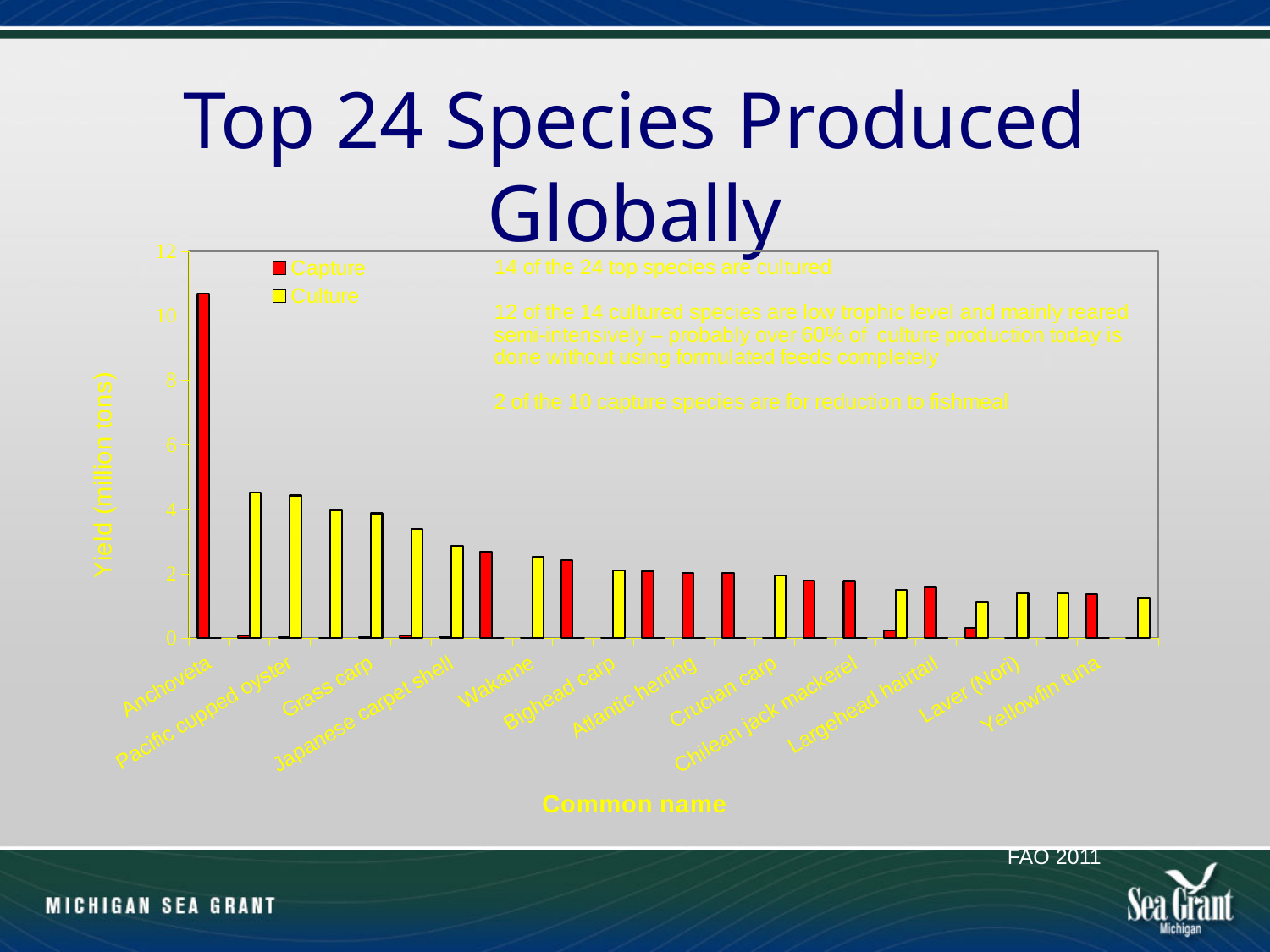
Is the yield for Japanese carpet shell greater or less than 2 million tons? greater What are the two series named in the legend? Capture and Culture Is the yield for Pacific cupped oyster greater or less than 4 million tons? greater Is the yield for Anchoveta greater or less than 10 million tons? greater Which has the larger yield, Anchoveta or Pacific cupped oyster? Anchoveta What kind of chart is shown on the slide? Bar chart Do the yields generally rise or fall moving from left to right along the x axis? Fall How many species are plotted on the chart? 24 What is the title of the y axis? Yield (million tons) Which species has the highest yield on the chart? Anchoveta How many series does the legend list? 2